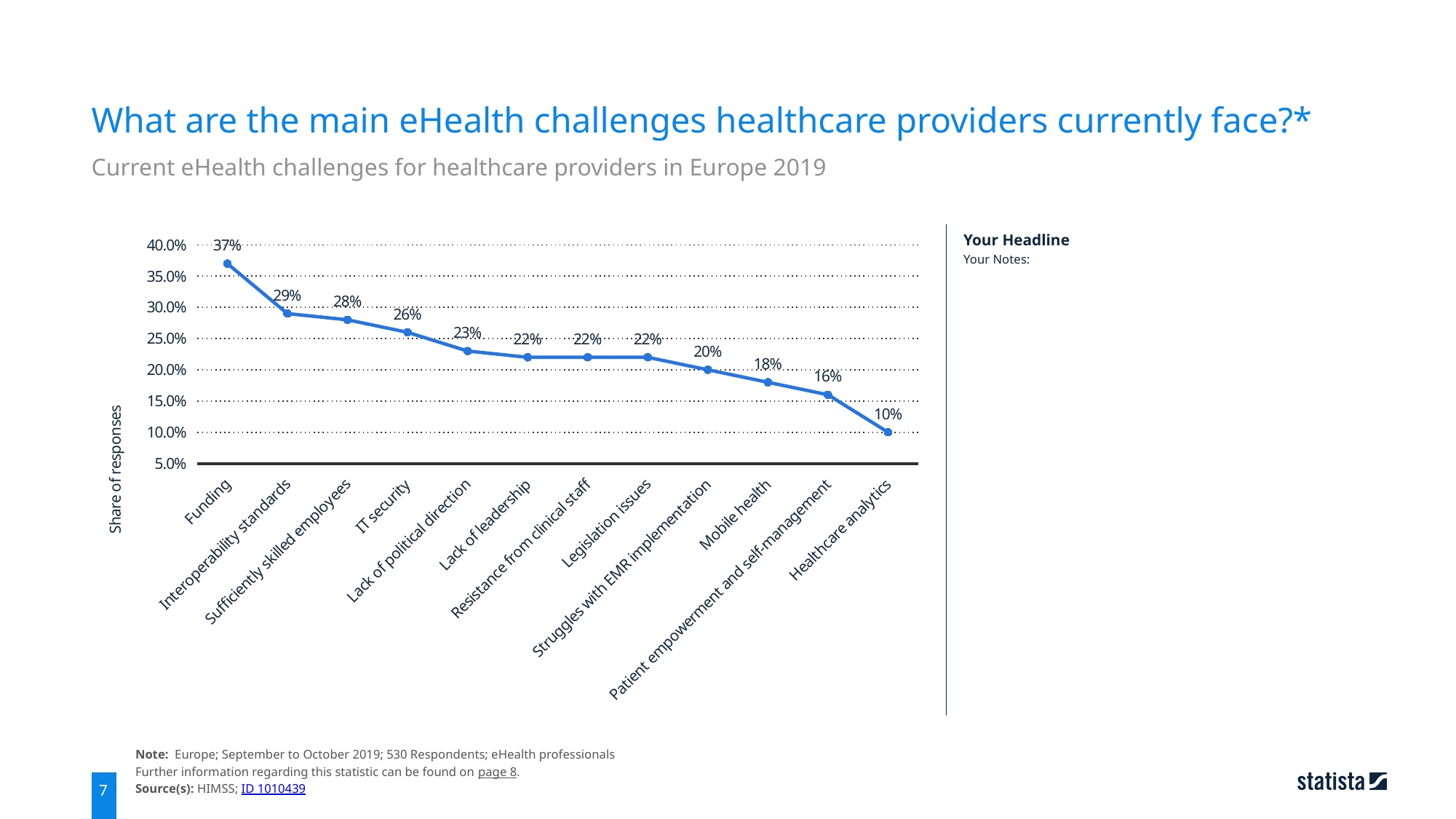
What is the share of responses for IT security? 26% What is the share of responses for Funding? 37% What kind of chart is shown on the slide? Line chart Is the value for Struggles with EMR implementation greater or less than 25.0%? less Do the values rise or fall from left to right along the x axis? Fall Which challenge has the highest share of responses? Funding How many challenges are plotted on the chart? 12 What is the difference in share of responses between Funding and Interoperability standards? 8% Which challenge has the lowest share of responses? Healthcare analytics Which has a larger share of responses, Sufficiently skilled employees or Lack of political direction? Sufficiently skilled employees What is the label of the vertical axis? Share of responses What is the share of responses for Mobile health? 18%